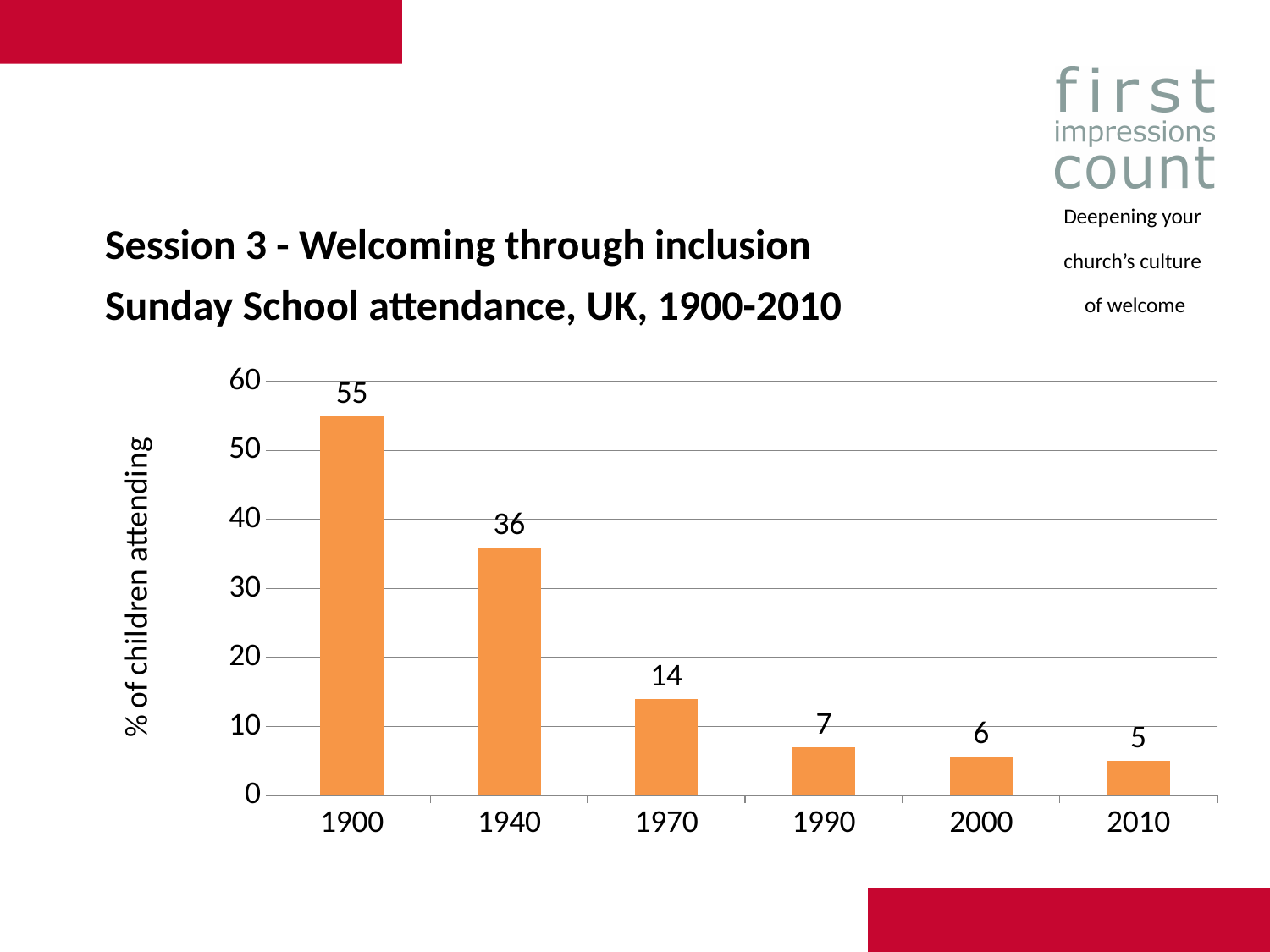
Which year has the highest value? 1900 How many years are shown on the x axis? 6 What is the label on the vertical axis? % of children attending What is the difference between the values for 1970 and 1990? 7 What kind of chart is this? bar chart What is the value for 1970? 14 What is the value for 1900? 55 Do the values rise or fall from 1900 to 2010? fall Which is larger, the value for 1940 or the value for 1970? 1940 Which year has the lowest value? 2010 What is the difference between the values for 1900 and 1940? 19 What is the value for 2010? 5